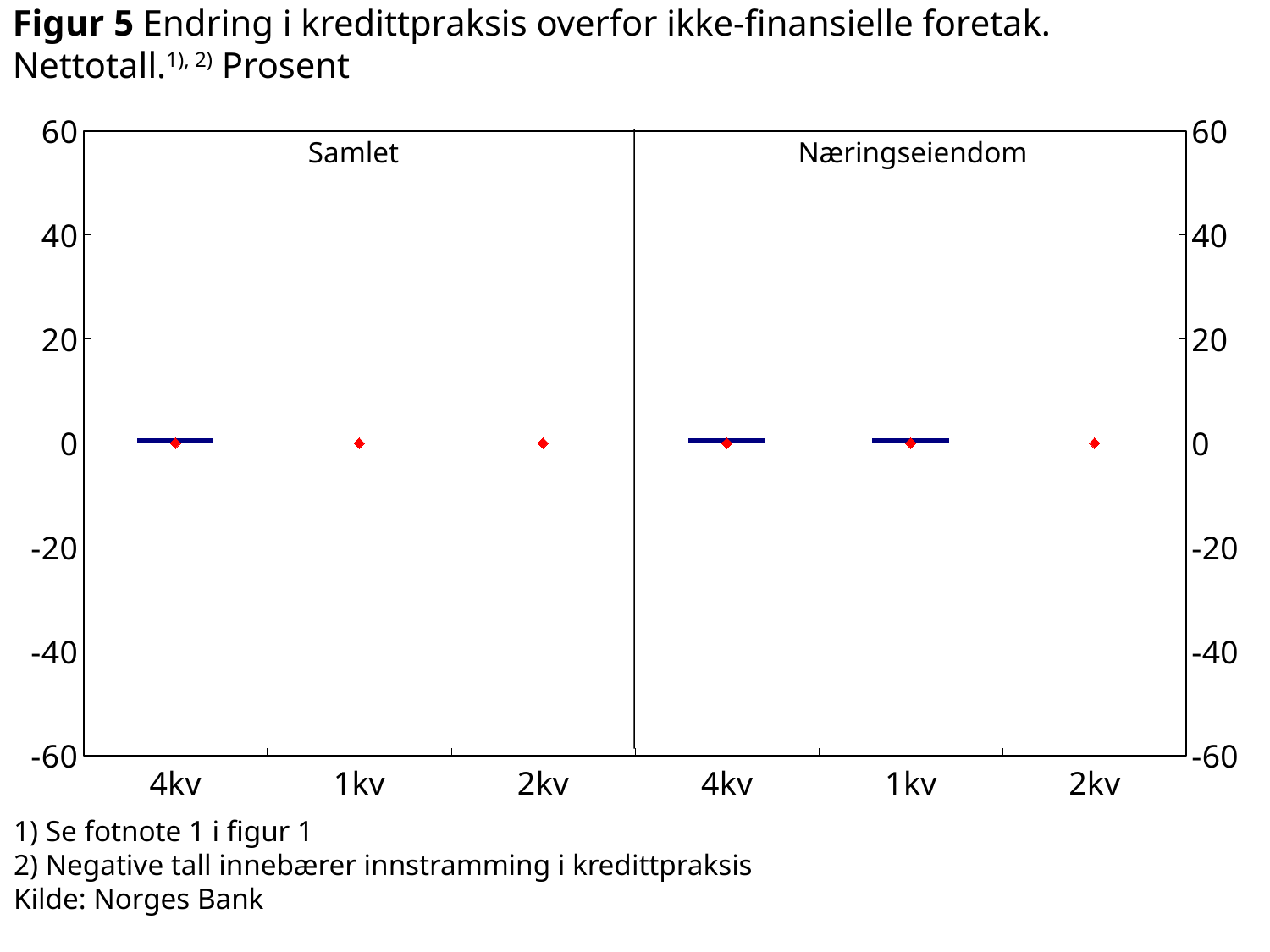
What is the highest value shown on the y axis? 60 What kind of chart is shown on the slide? bar chart Is the value for 4kv in the Samlet panel greater or less than 20? less What are the names of the two panels in the chart? Samlet and Næringseiendom Is the value for 4kv in the Samlet panel greater or less than -20? greater How many quarters are shown on the x axis in the Samlet panel? 3 How many panels does the chart have? 2 Is the value for 2kv in the Næringseiendom panel greater or less than -20? greater How many quarters are shown on the x axis in the Næringseiendom panel? 3